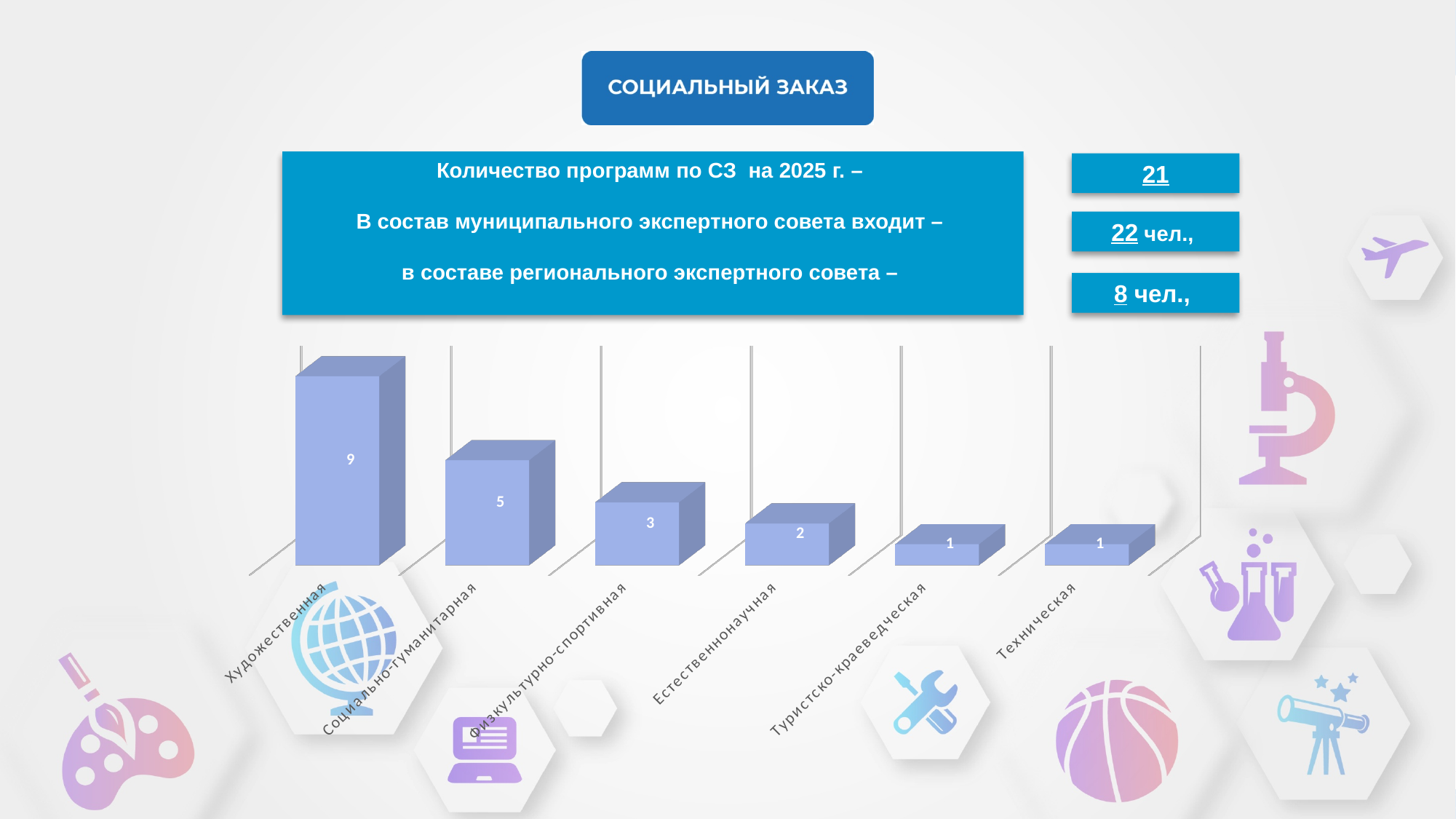
Which is larger, the value for Социально-гуманитарная or the value for Физкультурно-спортивная? Социально-гуманитарная What is the difference between the values for Художественная and Социально-гуманитарная? 4 What is the value for Техническая? 1 Do the values rise or fall from left to right across the categories? fall Which category has the highest value? Художественная What is the value for Естественнонаучная? 2 What is the value for Физкультурно-спортивная? 3 How many categories are shown in the chart? 6 What is the difference between the values for Физкультурно-спортивная and Естественнонаучная? 1 What kind of chart is shown on the slide? bar chart What is the value for Художественная? 9 What is the value for Социально-гуманитарная? 5